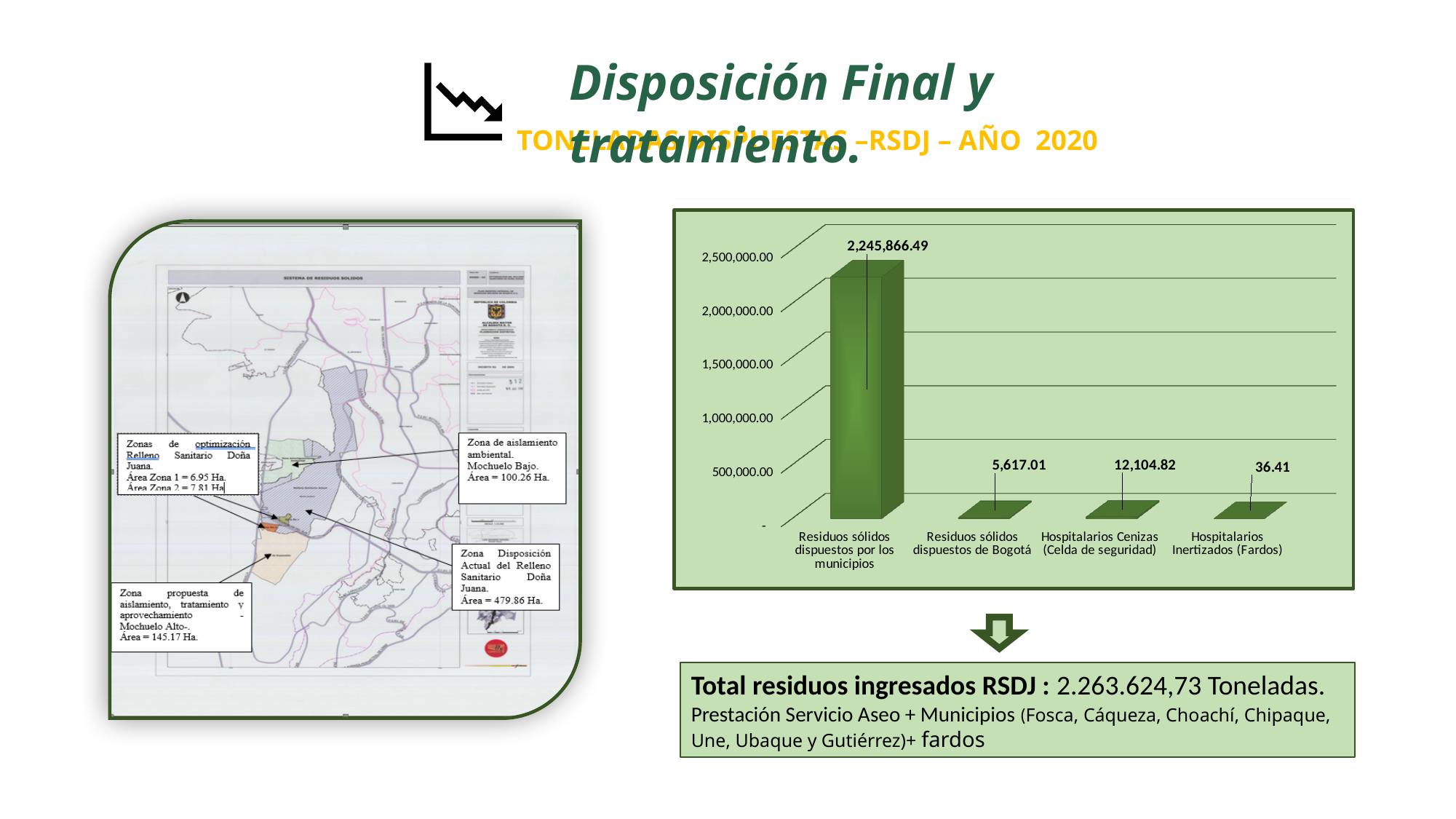
Is the value for Residuos sólidos dispuestos por los municipios greater or less than 2,000,000.00? greater What kind of chart is shown on the slide? bar chart What is the value for Hospitalarios Inertizados (Fardos)? 36.41 Which category has the highest value? Residuos sólidos dispuestos por los municipios Which category has the lowest value? Hospitalarios Inertizados (Fardos) What is the value for Hospitalarios Cenizas (Celda de seguridad)? 12,104.82 Which is larger, Hospitalarios Cenizas (Celda de seguridad) or Residuos sólidos dispuestos de Bogotá? Hospitalarios Cenizas (Celda de seguridad) What is the difference between Residuos sólidos dispuestos de Bogotá and Hospitalarios Inertizados (Fardos)? 5,580.60 What is the value for Residuos sólidos dispuestos de Bogotá? 5,617.01 What is the value for Residuos sólidos dispuestos por los municipios? 2,245,866.49 How many categories are shown in the chart? 4 What is the difference between Hospitalarios Cenizas (Celda de seguridad) and Residuos sólidos dispuestos de Bogotá? 6,487.81